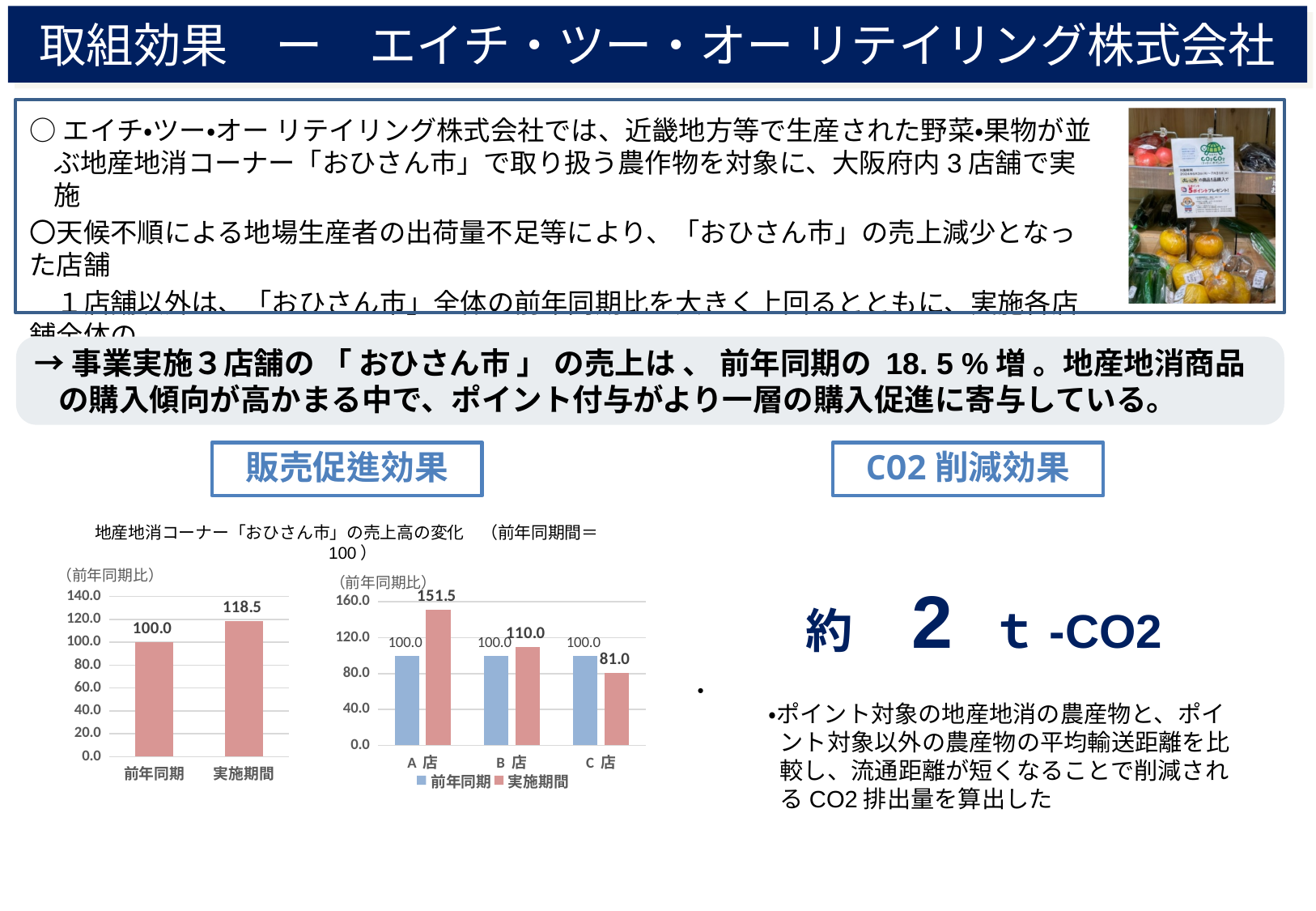
In the right bar chart, what is the difference between the 実施期間 values of A 店 and C 店? 70.5 In the left bar chart, what is the difference between the 実施期間 value and the 前年同期 value? 18.5 In the right bar chart, what is the 実施期間 value for A 店? 151.5 In the left bar chart, what is the value for 前年同期? 100.0 In the right bar chart, is the 実施期間 value for C 店 larger or smaller than its 前年同期 value? smaller In the right bar chart, what is the 実施期間 value for C 店? 81.0 In the right bar chart, what is the 実施期間 value for B 店? 110.0 How many series does the legend of the right bar chart list? 2 In the right bar chart, which store has the lowest 実施期間 value? C 店 How many store categories are shown on the x axis of the right bar chart? 3 In the left bar chart, what is the value for 実施期間? 118.5 In the right bar chart, which store has the highest 実施期間 value? A 店